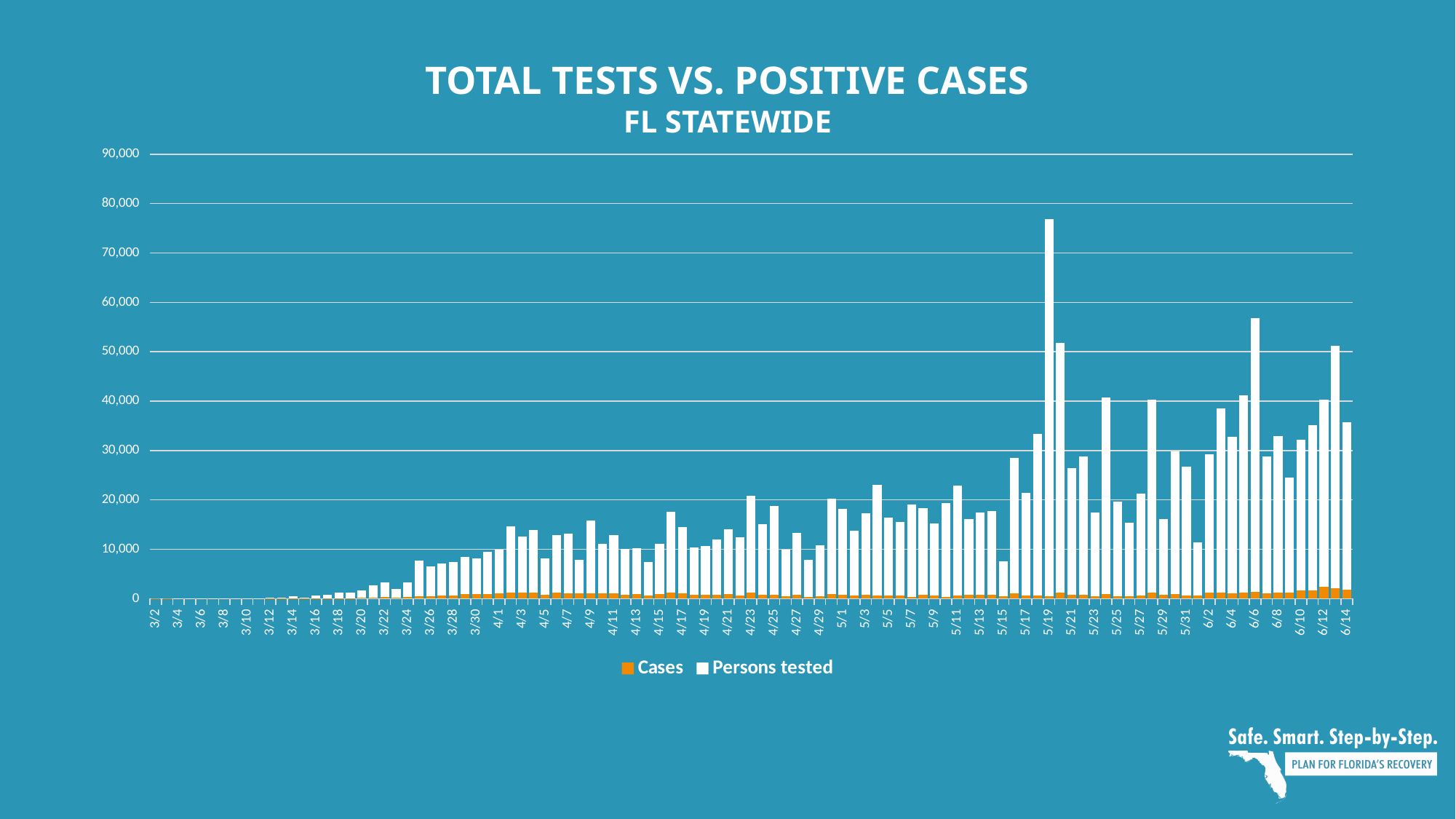
What is the title of the chart? TOTAL TESTS VS. POSITIVE CASES FL STATEWIDE Is the Persons tested value for 3/2 greater or less than 10,000? less Which date has the larger Persons tested value, 5/19 or 6/6? 5/19 What kind of chart is shown on the slide? Bar chart Is the Persons tested value for 5/19 greater or less than 70,000? greater Is the Persons tested value for 6/6 greater or less than 50,000? greater Which colour represents the Cases series in the legend? Orange On 6/14, which series has the larger value, Cases or Persons tested? Persons tested How many series does the legend list? 2 On which date is the Persons tested value highest? 5/19 Overall, do the Persons tested values rise or fall from March to June? Rise